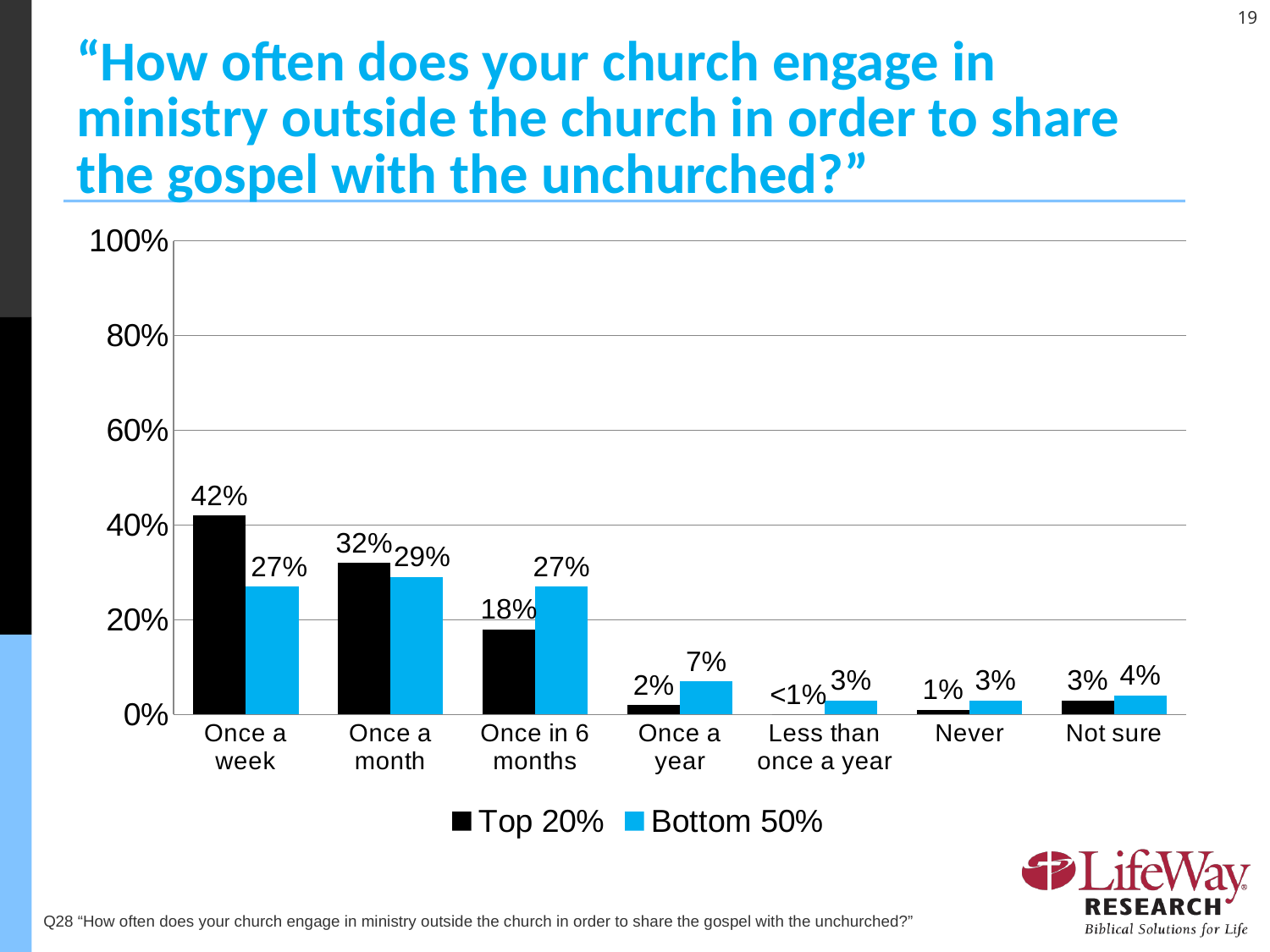
How many categories are shown on the x axis? 7 How many series does the legend list? 2 What is the difference between Top 20% and Bottom 50% for "Once a week"? 15% Which is larger for "Once in 6 months": Top 20% or Bottom 50%? Bottom 50% Which colour represents the Bottom 50% series? Blue What is the value for Top 20% for "Once a week"? 42% What is the value for Bottom 50% for "Once in 6 months"? 27% Which category has the highest value for Top 20%? Once a week What is the value for Top 20% for "Less than once a year"? <1% Is the value for Top 20% for "Once a month" greater or less than 40%? less What kind of chart is shown on the slide? Bar chart